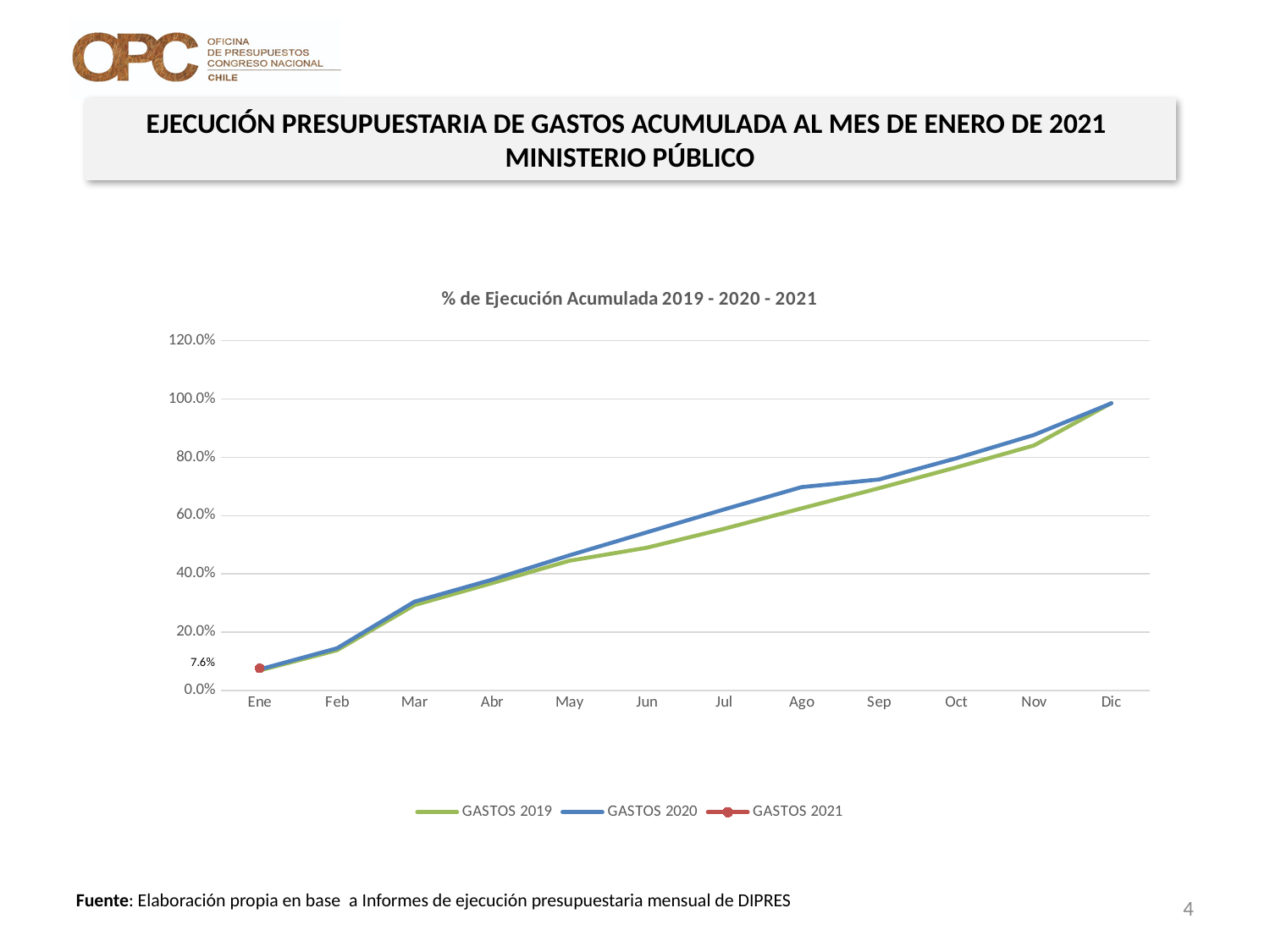
Is the value for GASTOS 2019 in Mar greater or less than 40%? less Is the value for GASTOS 2019 in Jun greater or less than 60%? less What is the title of the chart? % de Ejecución Acumulada 2019 - 2020 - 2021 In Ago, which series has the higher value, GASTOS 2019 or GASTOS 2020? GASTOS 2020 Do the values for GASTOS 2020 rise or fall from Ene to Dic? Rise How many series does the legend list? 3 How many months are shown along the x axis? 12 Is the value for GASTOS 2020 in Ago greater or less than 60%? greater In which month does GASTOS 2020 reach its highest value? Dic What is the value for GASTOS 2021 in Ene? 7.6% What kind of chart is shown on the slide? Line chart In which month is the value for GASTOS 2019 lowest? Ene